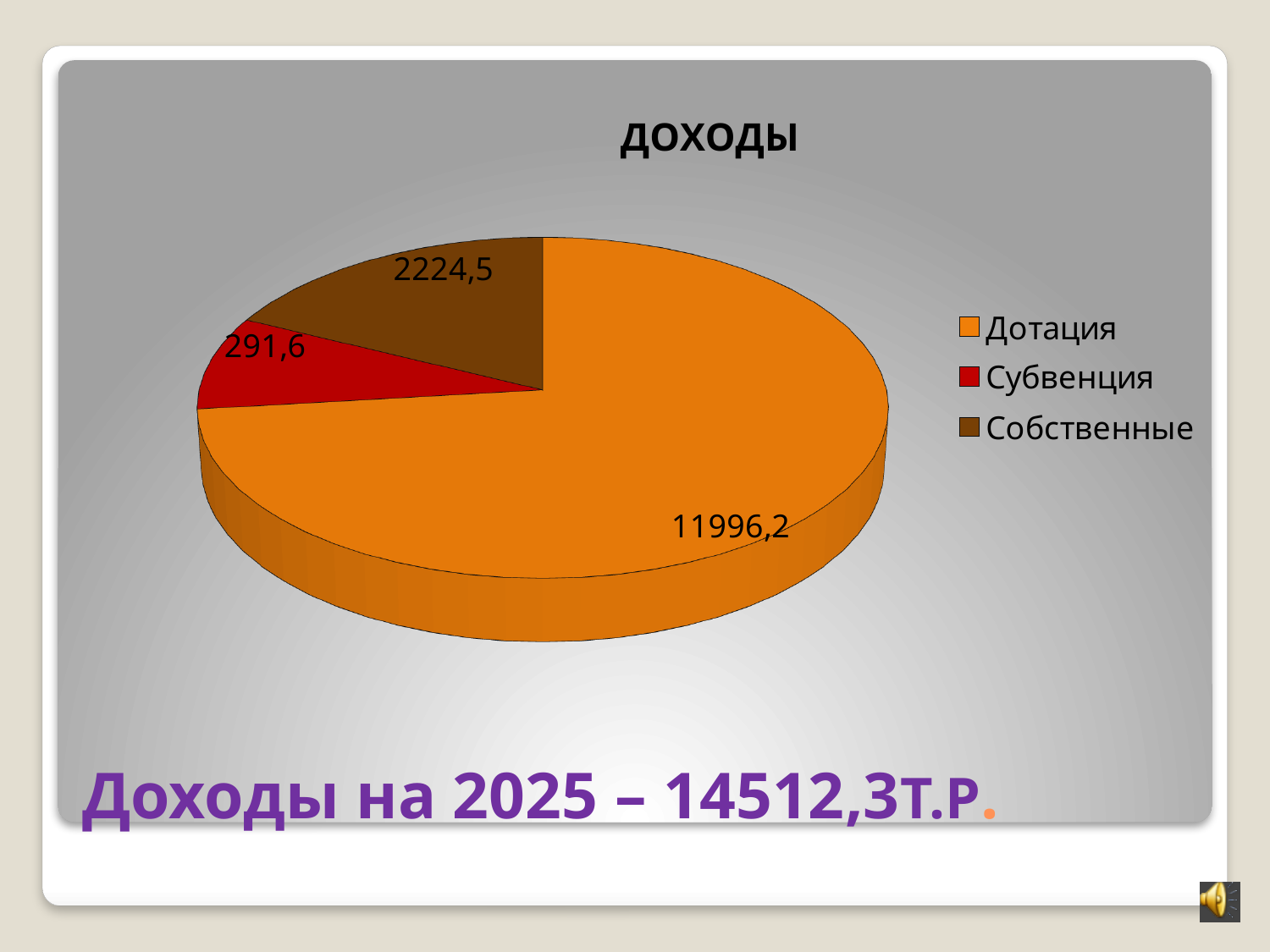
What is the value for Дотация? 11996,2 What is the value for Субвенция? 291,6 What colour is the slice for Субвенция? Red How many categories does the legend list? 3 Which category has the largest slice of the pie? Дотация What is the value for Собственные? 2224,5 Which is larger, the value for Собственные or the value for Субвенция? Собственные Which category has the smallest slice of the pie? Субвенция What type of chart is shown on the slide? Pie chart How many slices does the pie chart have? 3 What is the difference between the values for Дотация and Собственные? 9771,7 What is the title of the chart? ДОХОДЫ